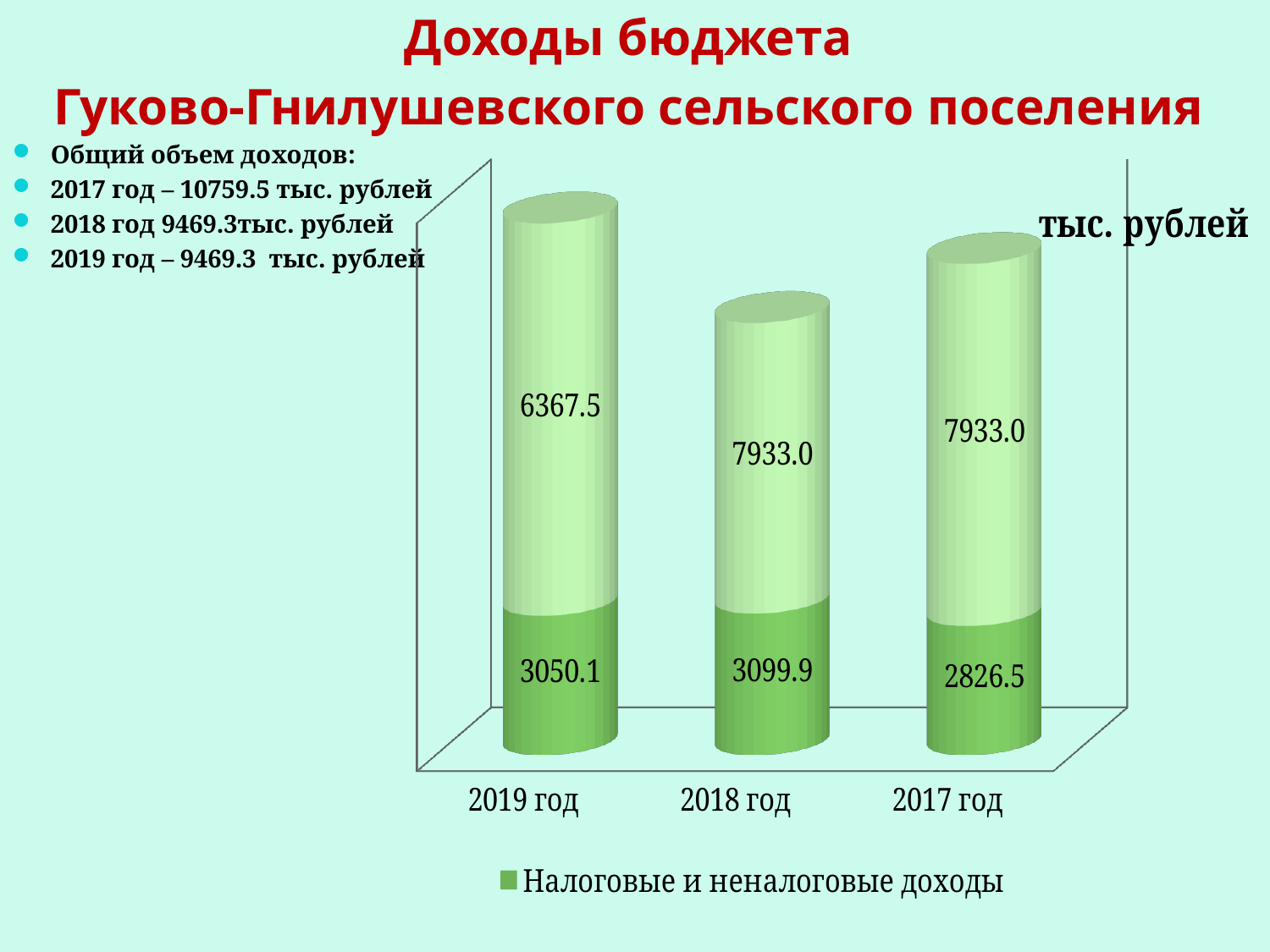
Which year has the highest value for Налоговые и неналоговые доходы? 2018 год What kind of chart is shown on the slide? Stacked bar chart Which is larger, the Налоговые и неналоговые доходы value for 2019 год or for 2017 год? 2019 год What value is printed on the upper (light green) segment of the 2018 год bar? 7933.0 What is the total of the two segments of the 2017 год bar? 10759.5 Which year has the lowest value for Налоговые и неналоговые доходы? 2017 год What is the value of Налоговые и неналоговые доходы for 2019 год? 3050.1 How many series does the chart legend list? 1 What is the difference between the Налоговые и неналоговые доходы values for 2018 год and 2017 год? 273.4 How many years are shown on the x axis of the chart? 3 What is the value of Налоговые и неналоговые доходы for 2017 год? 2826.5